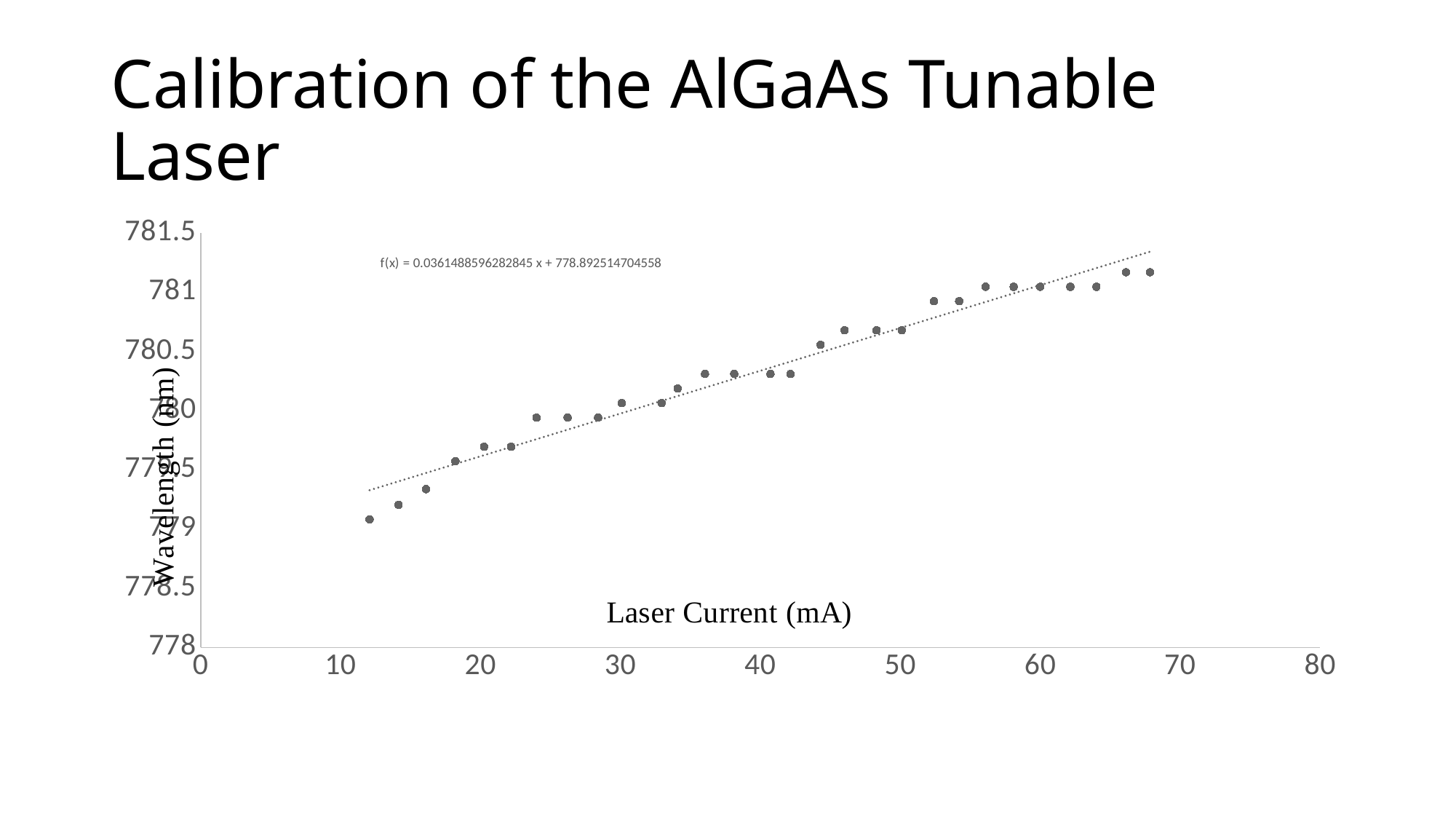
Is the wavelength value at a laser current of about 12 mA greater or less than 779.5? less What is the label of the x axis? Laser Current (mA) Do the wavelength values rise or fall as laser current increases along the x axis? Rise Is the wavelength value at a laser current of about 50 mA greater or less than 780.5? greater Is the wavelength value at a laser current of about 20 mA greater or less than 780? less Which has the larger wavelength: the point at about 30 mA or the point at about 60 mA? The point at about 60 mA What kind of chart is shown on the slide? Scatter chart What is the slope of the fitted trendline equation shown on the chart? 0.0361488596282845 What is the highest value shown on the x axis? 80